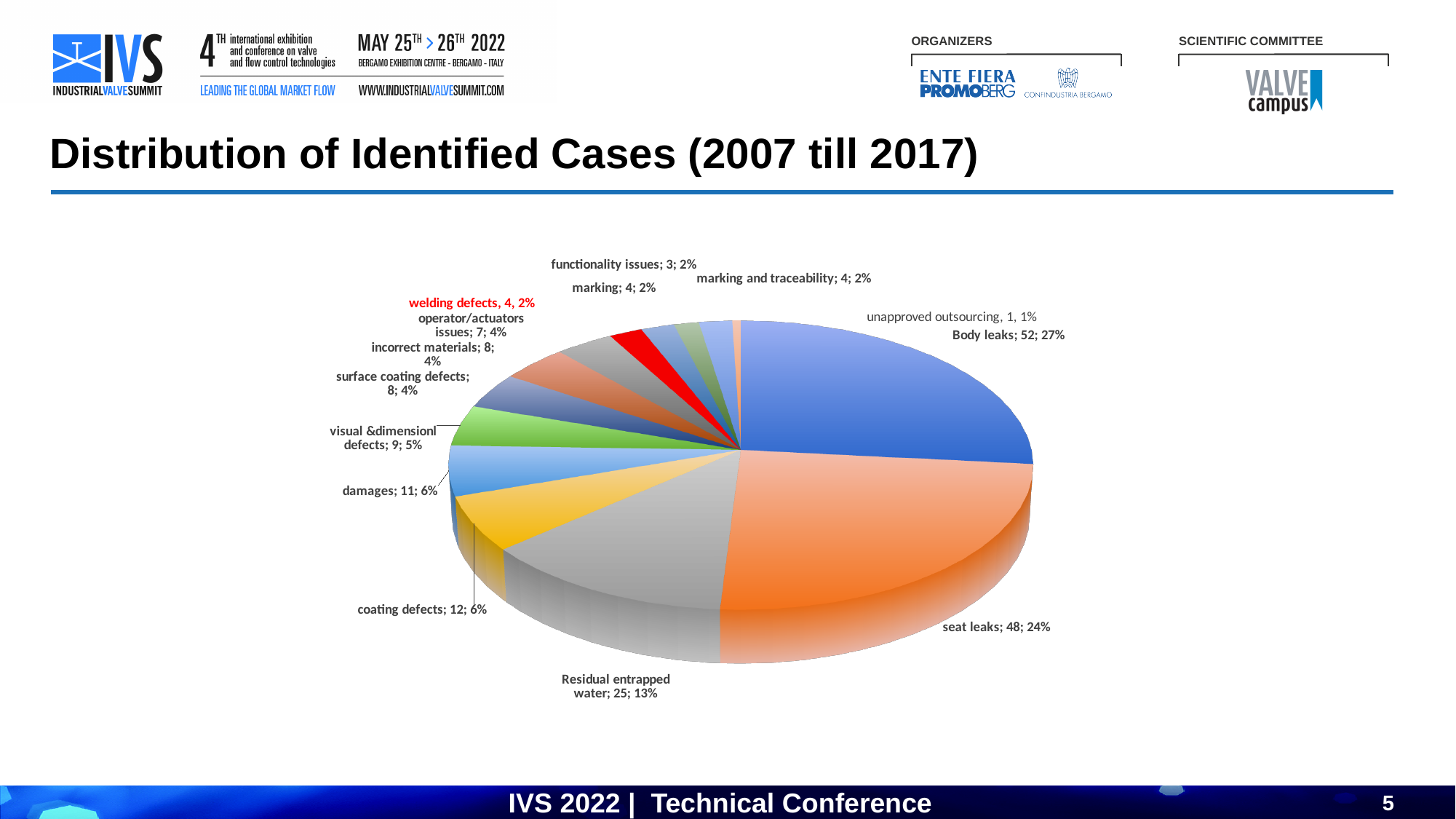
What share of the pie is labelled for seat leaks? 24% Which has more cases, coating defects or damages? coating defects What share of the pie is labelled for visual & dimensional defects? 5% How many cases are labelled for Residual entrapped water? 25 What is the difference in the number of cases between Body leaks and seat leaks? 4 What is the title of the slide containing the pie chart? Distribution of Identified Cases (2007 till 2017) How many cases are labelled for Body leaks? 52 What kind of chart is shown on the slide? pie chart How many categories are shown in the pie chart? 14 Which category has the largest slice of the pie? Body leaks How many cases are labelled for functionality issues? 3 Which category has the smallest slice of the pie? unapproved outsourcing